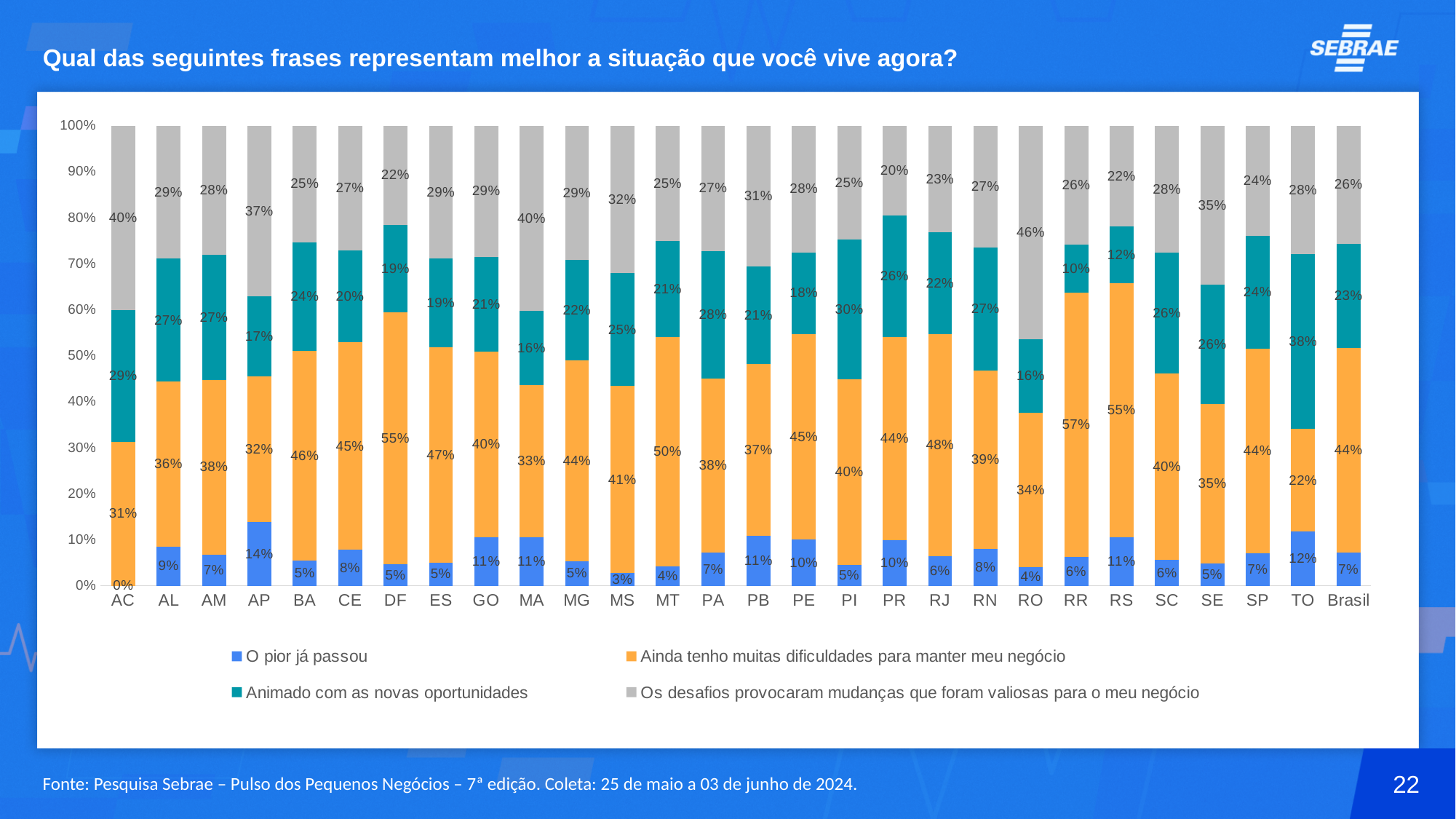
Which category has the lowest value for "O pior já passou"? AC Which is larger: the "Animado com as novas oportunidades" value for PI or for RS? PI Which category has the highest value for "Os desafios provocaram mudanças que foram valiosas para o meu negócio"? RO How many series does the legend list? 4 What is the value of "Os desafios provocaram mudanças que foram valiosas para o meu negócio" for SE? 35% What is the value of "Ainda tenho muitas dificuldades para manter meu negócio" for Brasil? 44% How many categories are shown on the x axis? 28 What type of chart is shown on the slide? stacked bar chart What is the value of "O pior já passou" for AP? 14% Which category has the highest value for "Ainda tenho muitas dificuldades para manter meu negócio"? RR What is the value of "Animado com as novas oportunidades" for TO? 38% What is the difference between the "Ainda tenho muitas dificuldades para manter meu negócio" values for RR and TO? 35%